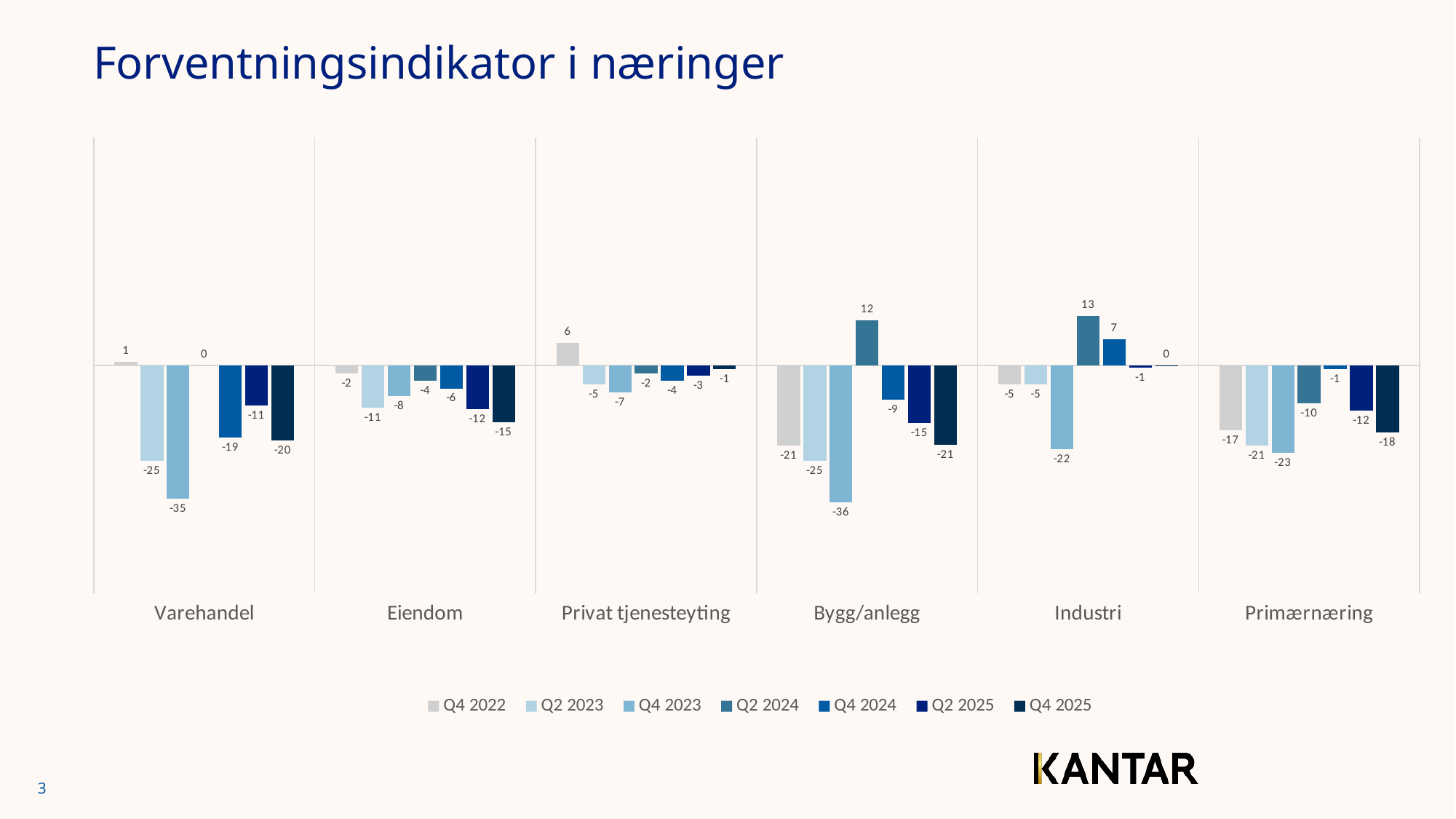
What is the title of the chart on the slide? Forventningsindikator i næringer What is the value for Varehandel in Q4 2023? -35 How many series does the legend list? 7 What is the value for Privat tjenesteyting in Q4 2022? 6 What kind of chart is shown on the slide? Bar chart What is the value for Primærnæring in Q4 2025? -18 What is the value for Industri in Q2 2024? 13 Which category has the highest value in Q4 2025? Industri What is the difference between the Q2 2024 and Q4 2023 values for Bygg/anlegg? 48 Which category has the lowest value in Q4 2023? Bygg/anlegg How many categories are shown on the x axis? 6 Which is larger for Eiendom: the Q2 2023 value or the Q4 2023 value? Q4 2023